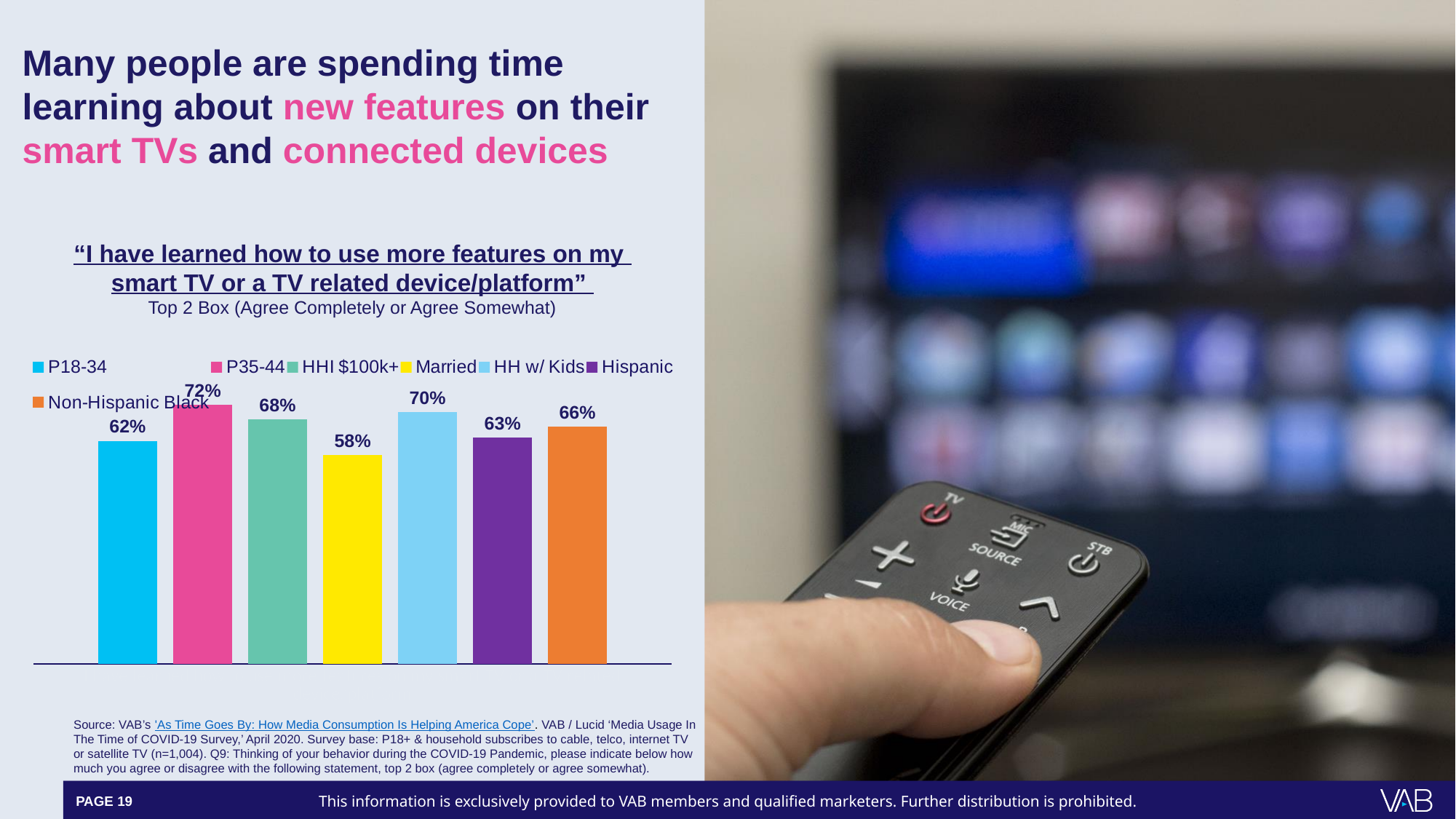
What is the difference between the values for P35-44 and P18-34? 10% How many bars are plotted in the chart? 7 What type of chart is shown on the slide? Bar chart What is the value shown for Non-Hispanic Black? 66% What percentage of P18-34 agree they have learned how to use more features on their smart TV or TV related device? 62% Which group has the highest value in the chart? P35-44 Which group has the lowest value in the chart? Married What is the value shown for the Married group? 58% What is the value shown for HH w/ Kids? 70% What is the difference between the values for HHI $100k+ and Hispanic? 5% Which is larger, the value for HH w/ Kids or the value for HHI $100k+? HH w/ Kids How many entries does the chart legend list? 7